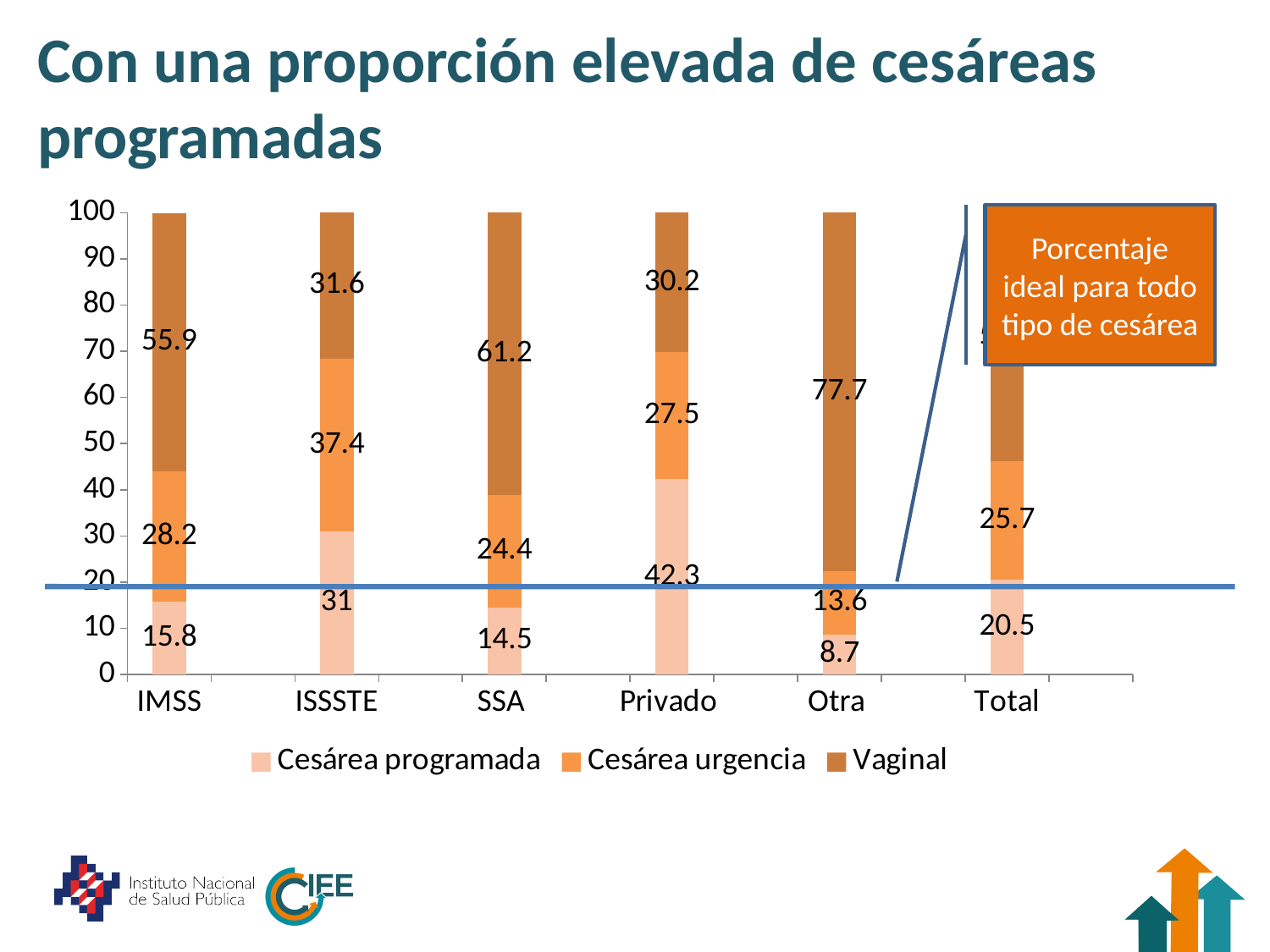
Which category has the highest value for Cesárea programada? Privado What is the value of Vaginal for SSA? 61.2 What is the value of Cesárea programada for IMSS? 15.8 Which category has the highest value for Vaginal? Otra Which category has the lowest value for Cesárea programada? Otra What is the value of Cesárea urgencia for ISSSTE? 37.4 What is the value of Cesárea programada for Total? 20.5 What kind of chart is shown on the slide? Stacked bar chart What is the difference between the Vaginal values for Otra and Privado? 47.5 How many series does the legend list? 3 How many categories are shown on the x axis? 6 Which is larger, the Cesárea urgencia value for IMSS or for SSA? IMSS